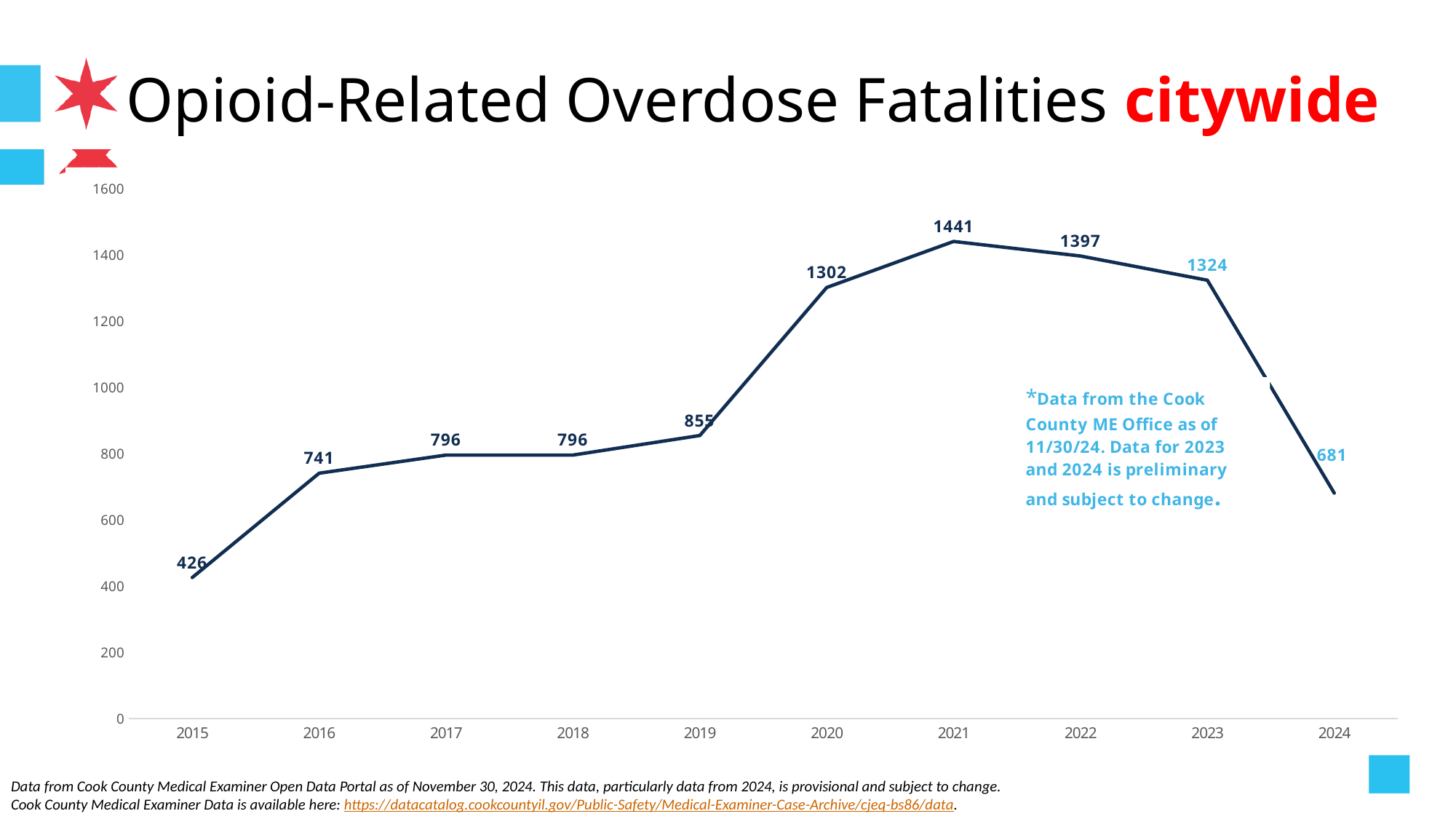
How many years are plotted on the x axis? 10 What kind of chart is shown on the slide? Line chart Which year had more fatalities, 2022 or 2023? 2022 What is the title of the chart on the slide? Opioid-Related Overdose Fatalities citywide Which year has the lowest number of fatalities? 2015 What was the number of opioid-related overdose fatalities in 2015? 426 What value is shown for 2024? 681 Which year has the highest number of fatalities? 2021 What is the difference between the 2021 value and the 2024 value? 760 What is the difference between the 2020 value and the 2019 value? 447 What was the number of opioid-related overdose fatalities in 2021? 1441 Do the values rise or fall from 2015 to 2021? Rise